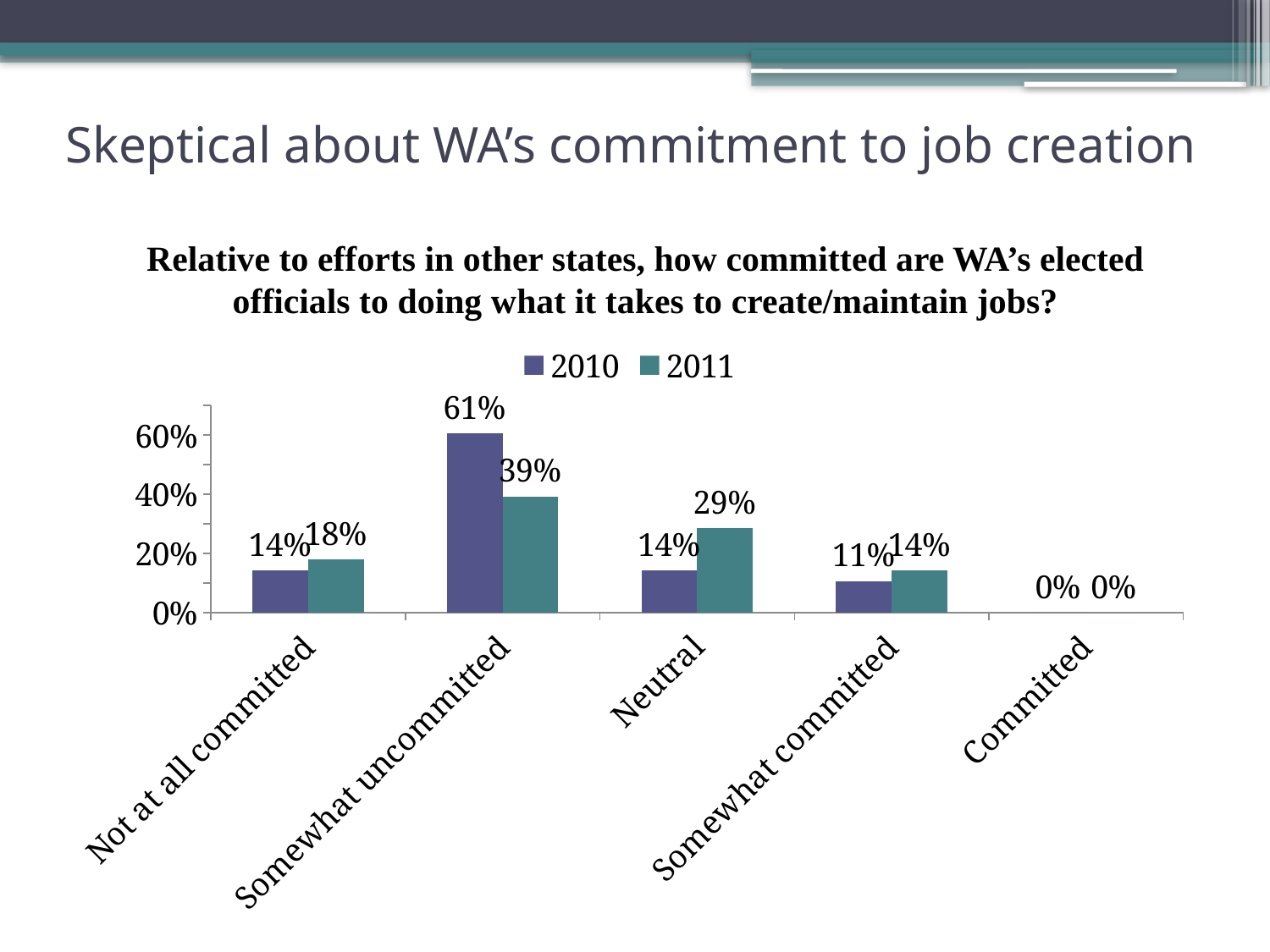
Which category has the lowest 2010 value? Committed What are the two series listed in the legend? 2010 and 2011 What is the difference between the 2010 and 2011 values for Somewhat uncommitted? 22% How many categories are shown on the x axis? 5 What is the 2011 value for Not at all committed? 18% What is the 2010 value for Somewhat uncommitted? 61% What kind of chart is shown on the slide? Bar chart What is the 2011 value for Neutral? 29% What is the 2010 value for Somewhat committed? 11% How many series does the legend list? 2 Which category has the highest 2011 value? Somewhat uncommitted Which is larger for Neutral, the 2010 value or the 2011 value? 2011